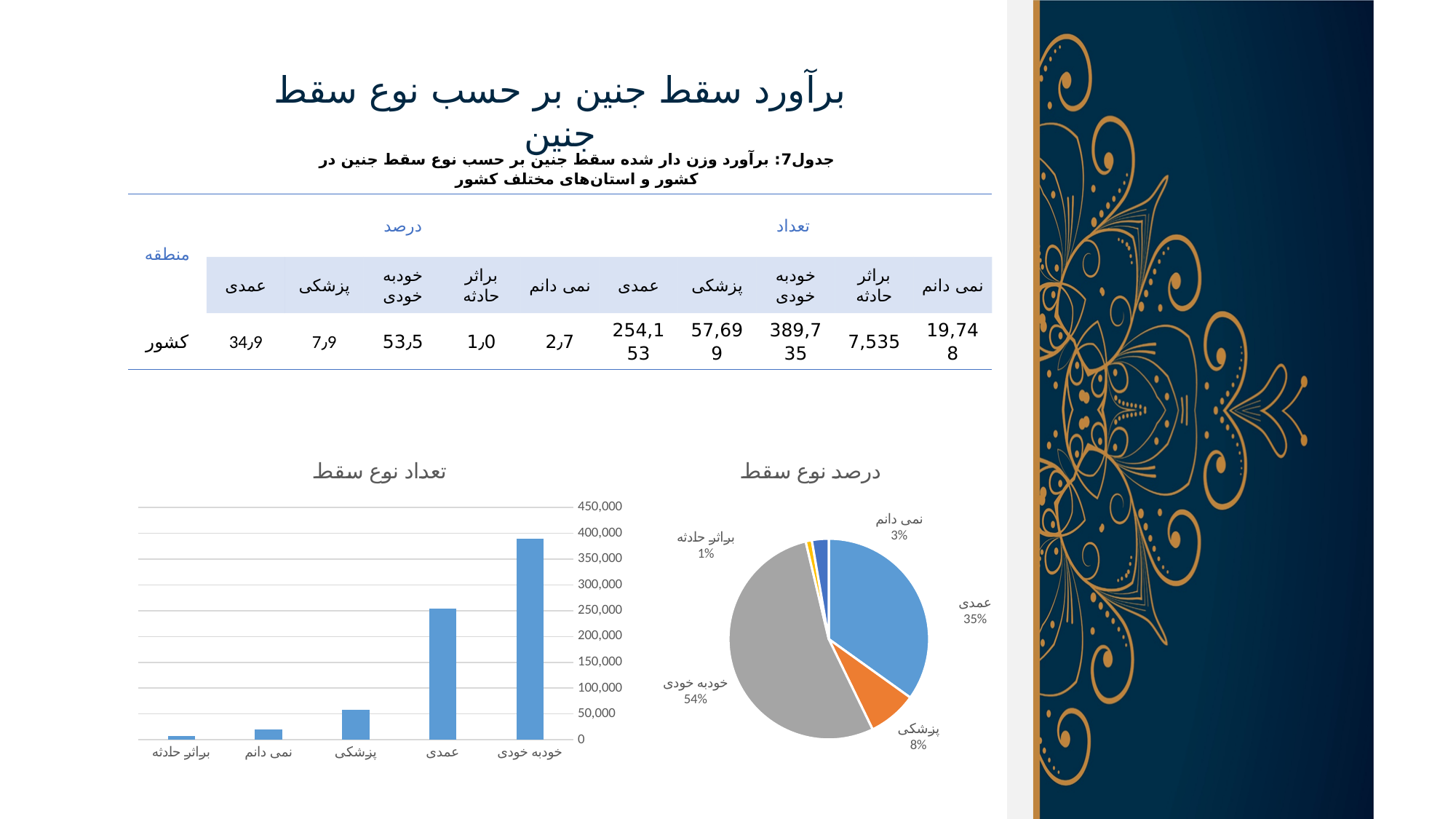
In the chart titled "درصد نوع سقط", what is the difference between the shares of عمدی and پزشکی? 27% In the chart titled "تعداد نوع سقط", which is larger, the bar for عمدی or the bar for پزشکی? عمدی In the chart titled "درصد نوع سقط", what share does خودبه خودی have? 54% In the chart titled "درصد نوع سقط", what percentage is shown for عمدی? 35% In the chart titled "درصد نوع سقط", how many slices does the pie have? 5 In the chart titled "تعداد نوع سقط", which category has the lowest bar? براثر حادثه In the chart titled "تعداد نوع سقط", is the value for عمدی greater or less than 200,000? greater What kind of chart is the chart titled "درصد نوع سقط"? pie chart In the chart titled "تعداد نوع سقط", how many categories are plotted? 5 In the chart titled "تعداد نوع سقط", which category has the highest bar? خودبه خودی What kind of chart is the chart titled "تعداد نوع سقط"? bar chart In the chart titled "تعداد نوع سقط", is the value for پزشکی greater or less than 100,000? less